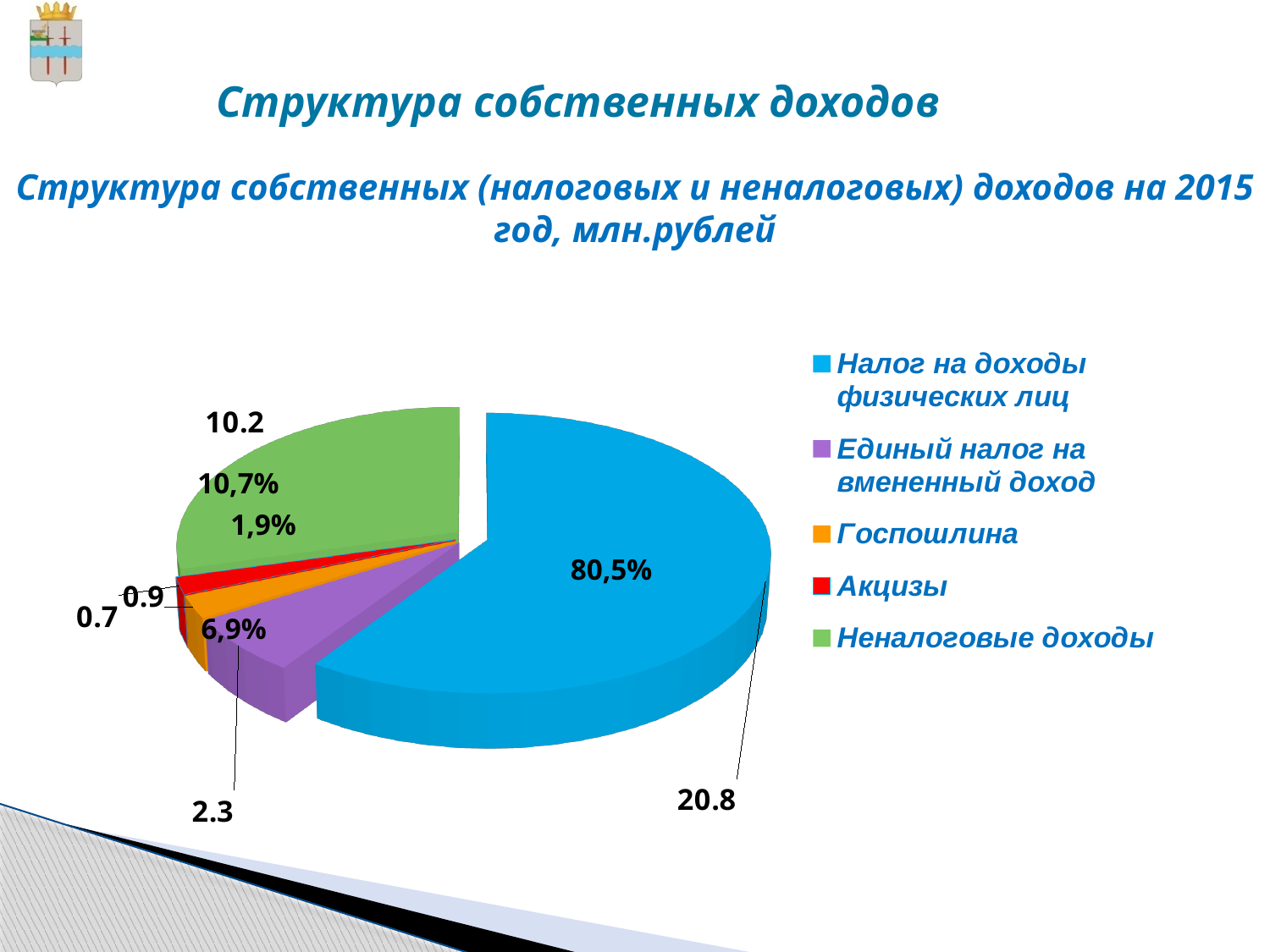
What is the value for Неналоговые доходы? 10.2 Which is larger, the value for Неналоговые доходы or the value for Единый налог на вмененный доход? Неналоговые доходы What is the value for Налог на доходы физических лиц? 20.8 What kind of chart is shown on the slide? pie chart How many entries does the legend list? 5 Which category has the largest slice of the pie? Налог на доходы физических лиц What percentage label is printed on the blue slice (Налог на доходы физических лиц)? 80,5% What colour is the slice for Акцизы? red How many slices does the pie chart have? 5 What is the difference between the values for Налог на доходы физических лиц and Неналоговые доходы? 10.6 What is the title of the chart? Структура собственных (налоговых и неналоговых) доходов на 2015 год, млн.рублей What is the value for Единый налог на вмененный доход? 2.3